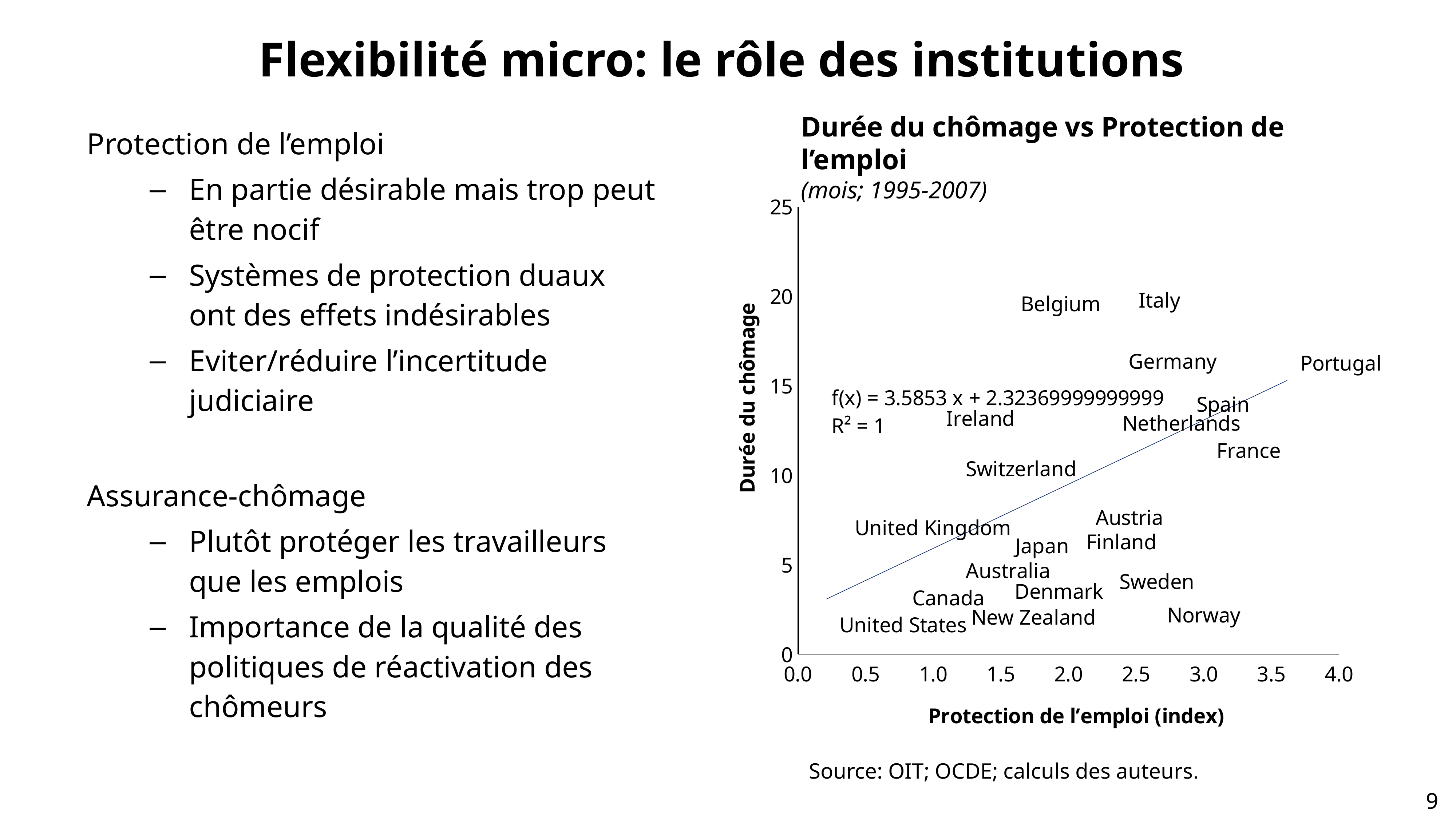
Is the unemployment duration for France greater or less than 15 months? less What kind of chart is shown on the slide? Scatter chart According to the fitted trend line, does unemployment duration rise or fall as the employment protection index increases? rise Which has a higher employment protection index, Portugal or the United States? Portugal What is the label of the x axis of the chart? Protection de l’emploi (index) Which country has the highest employment protection index on the chart? Portugal How many countries are plotted on the chart? 20 Which has a longer unemployment duration, Belgium or Switzerland? Belgium Is the unemployment duration for Austria greater or less than 5 months? greater Is the unemployment duration for Belgium greater or less than 15 months? greater Which country has the lowest employment protection index on the chart? United States